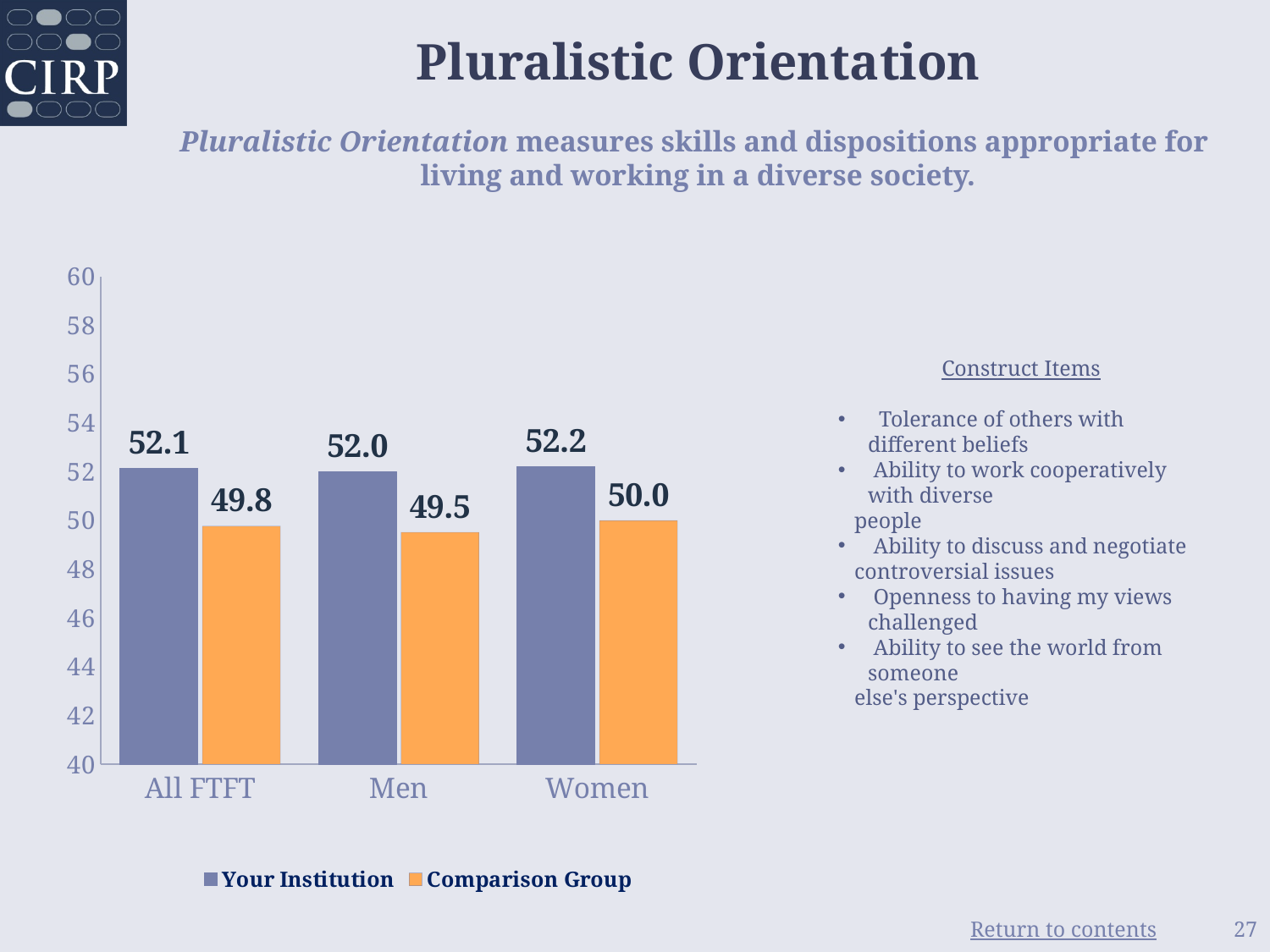
Which category has the lowest Comparison Group value? Men How many series does the legend list? 2 How many categories are shown on the x axis? 3 What is the value for the Comparison Group in the Women category? 50.0 Is the value for Your Institution in the Men category greater or less than 50? greater What is the value for the Comparison Group in the Men category? 49.5 Which is larger for Women: Your Institution or the Comparison Group? Your Institution What kind of chart is shown on the slide? bar chart What is the value for Your Institution in the Women category? 52.2 What is the difference between Your Institution and the Comparison Group for Men? 2.5 What is the value for Your Institution in the All FTFT category? 52.1 What is the difference between Your Institution and the Comparison Group for All FTFT? 2.3